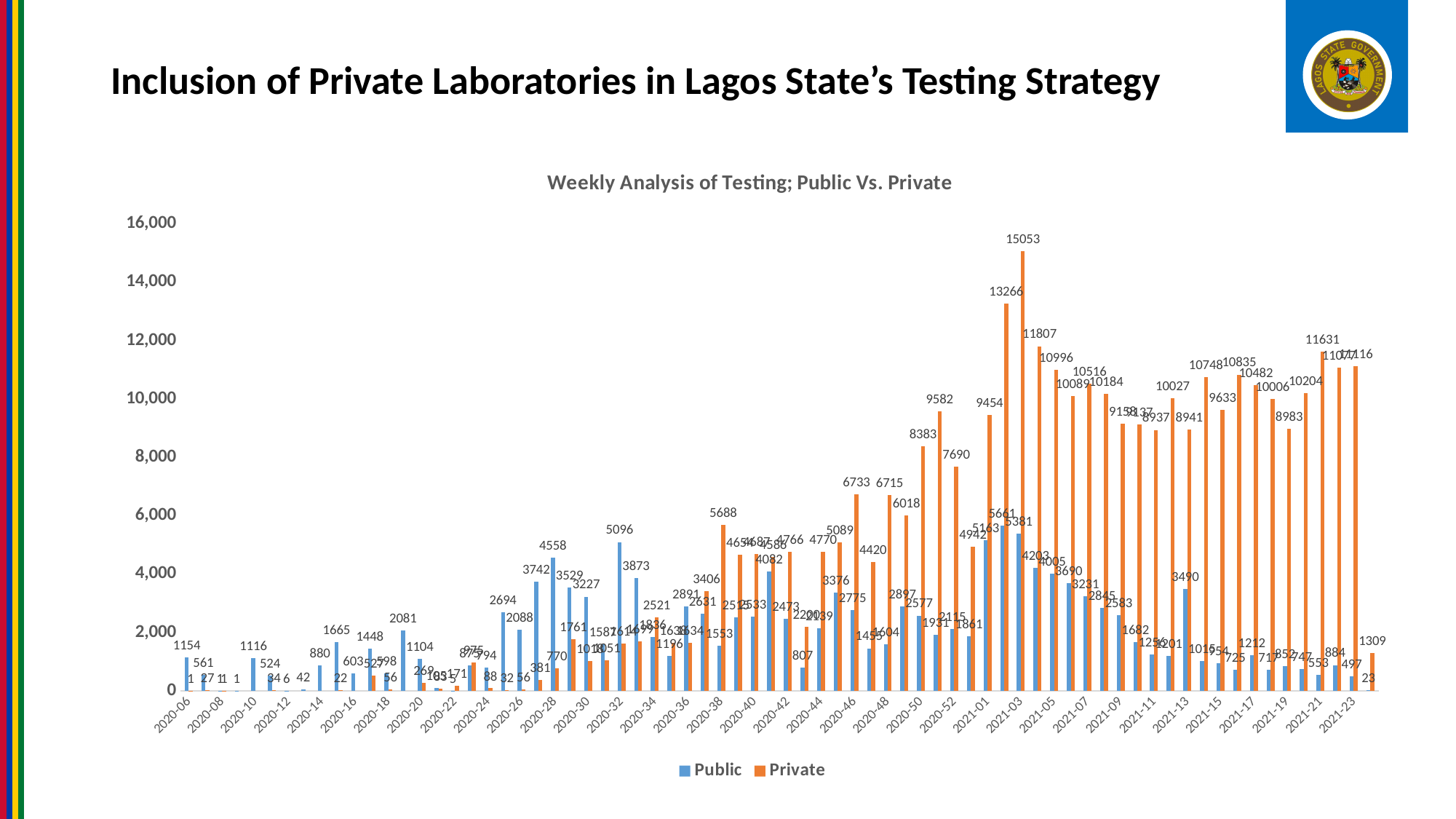
What is the Public value for week 2020-06? 1154 What is the title of the chart? Weekly Analysis of Testing; Public Vs. Private What are the two series named in the legend? Public and Private Which series contains the highest single value on the chart? Private What is the Public value for week 2021-23? 497 What is the Private value for week 2021-23? 11116 What kind of chart is shown on the slide? bar chart For week 2021-23, which is larger, the Public or the Private value? Private Is the highest Private value greater or less than 14,000? greater What is the highest value plotted for the Private series? 15053 How many series does the legend list? 2 What is the difference between the Private and Public values for week 2021-23? 10619